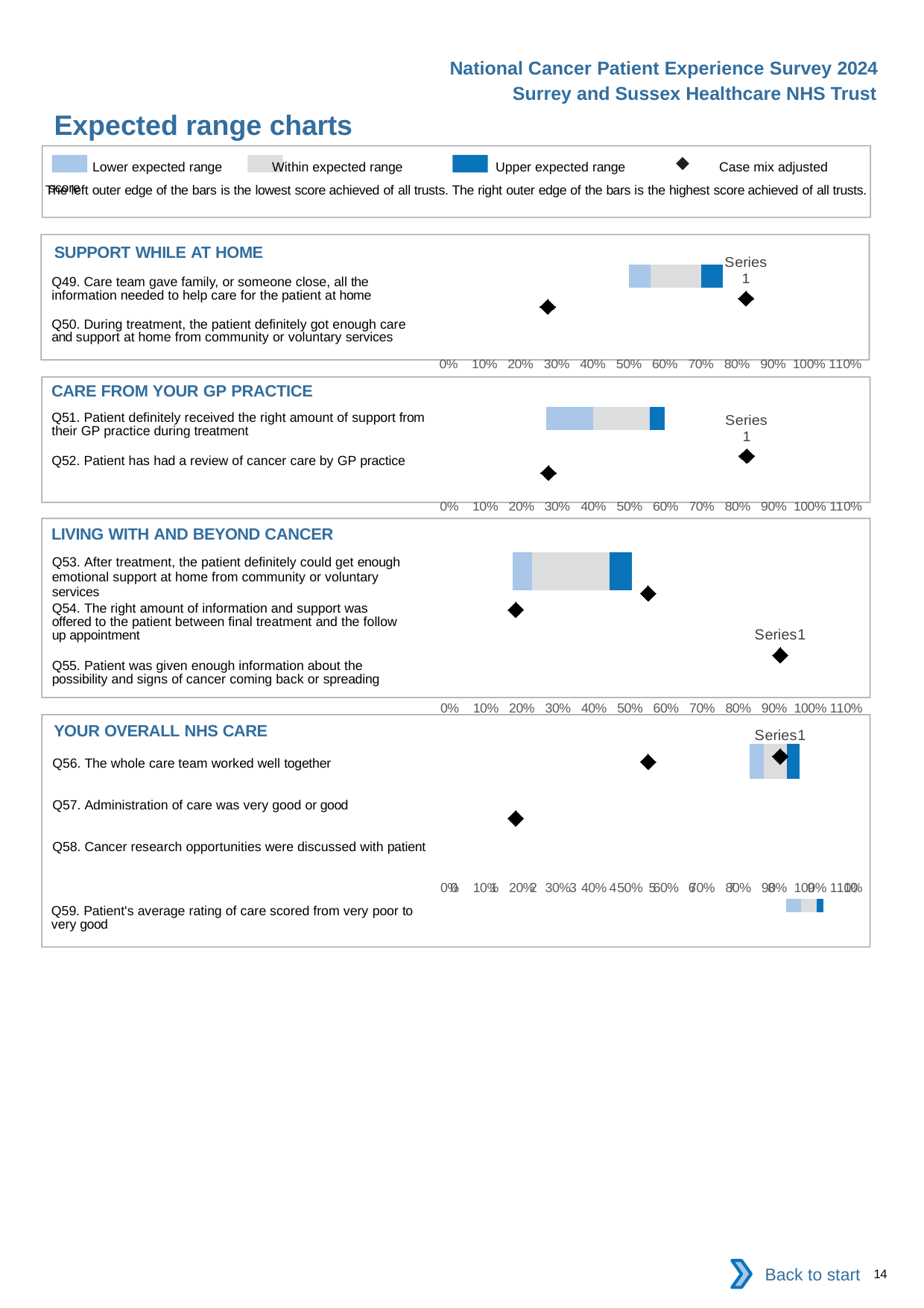
How many diamond markers are plotted in the LIVING WITH AND BEYOND CANCER chart? 3 In the LIVING WITH AND BEYOND CANCER chart, is the left edge of the expected range bar greater or less than 30%? less How many entries does the legend at the top of the slide list? 4 In the SUPPORT WHILE AT HOME chart, is the leftmost diamond marker greater or less than 40%? less In the SUPPORT WHILE AT HOME chart, is the rightmost diamond marker greater or less than 70%? greater Which legend entry is represented by the diamond marker? Case mix adjusted score How many questions are listed in the YOUR OVERALL NHS CARE chart? 4 How many questions are listed in the LIVING WITH AND BEYOND CANCER chart? 3 What kind of chart is used in the SUPPORT WHILE AT HOME section? bar chart